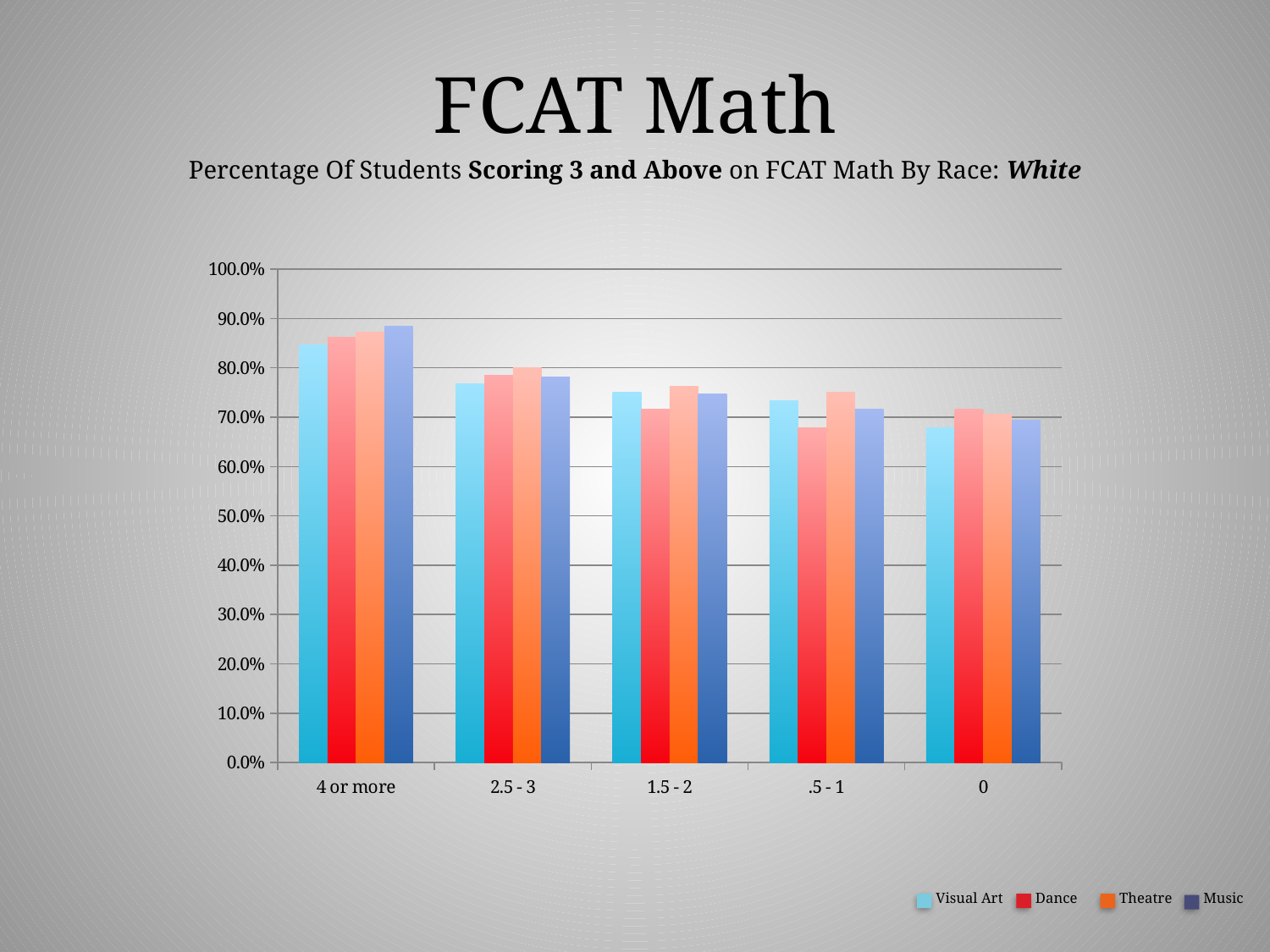
Do the Visual Art values rise or fall moving from "4 or more" to "0" along the x axis? fall Is the value for Music in the "4 or more" category greater or less than 80.0%? greater Which series is shown in orange in the legend? Theatre Is the value for Dance in the ".5 - 1" category greater or less than 70.0%? less In the ".5 - 1" category, which is larger: Visual Art or Dance? Visual Art In which category is the Dance value lowest? .5 - 1 Is the value for Visual Art in the "0" category greater or less than 70.0%? less What kind of chart is shown on the slide? bar chart How many categories are shown on the x axis? 5 In which category is the Visual Art value highest? 4 or more How many series does the legend list? 4